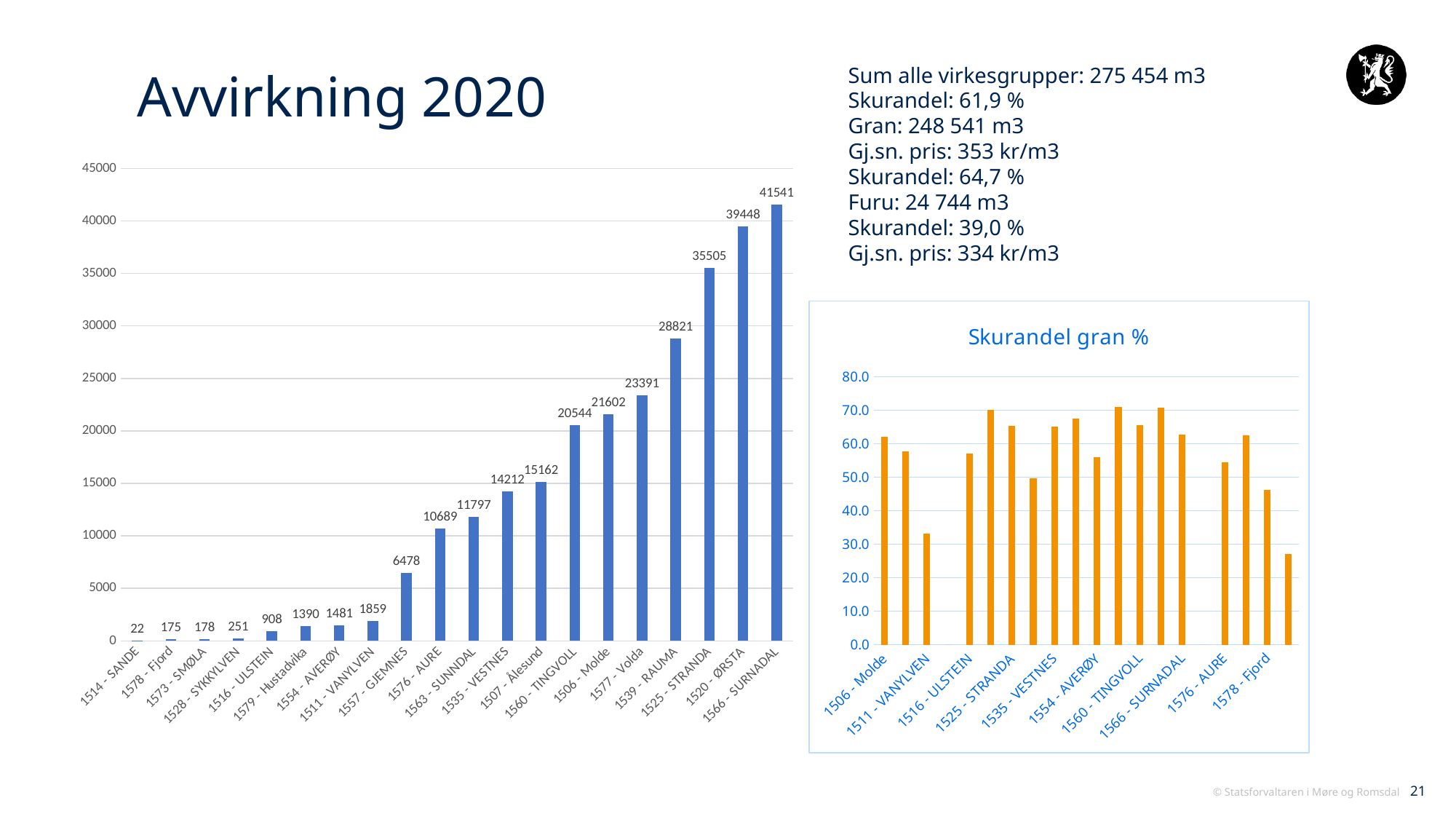
On the left bar chart, what is the value for 1566 - SURNADAL? 41541 In the 'Skurandel gran %' chart, is the value for 1578 - Fjord greater or less than 30.0? greater On the left bar chart, which is larger, the value for 1506 - Molde or the value for 1560 - TINGVOLL? 1506 - Molde On the left bar chart, which category has the highest value? 1566 - SURNADAL What is the title of the chart on the right side of the slide? Skurandel gran % How many categories are shown on the left bar chart? 20 On the left bar chart, do the values rise or fall from left to right along the x axis? rise On the left bar chart, what is the value for 1539 - RAUMA? 28821 What kind of chart is the left chart on the slide? bar chart On the left bar chart, what is the value for 1557 - GJEMNES? 6478 On the left bar chart, what is the difference between the values for 1520 - ØRSTA and 1525 - STRANDA? 3943 On the left bar chart, which category has the lowest value? 1514 - SANDE